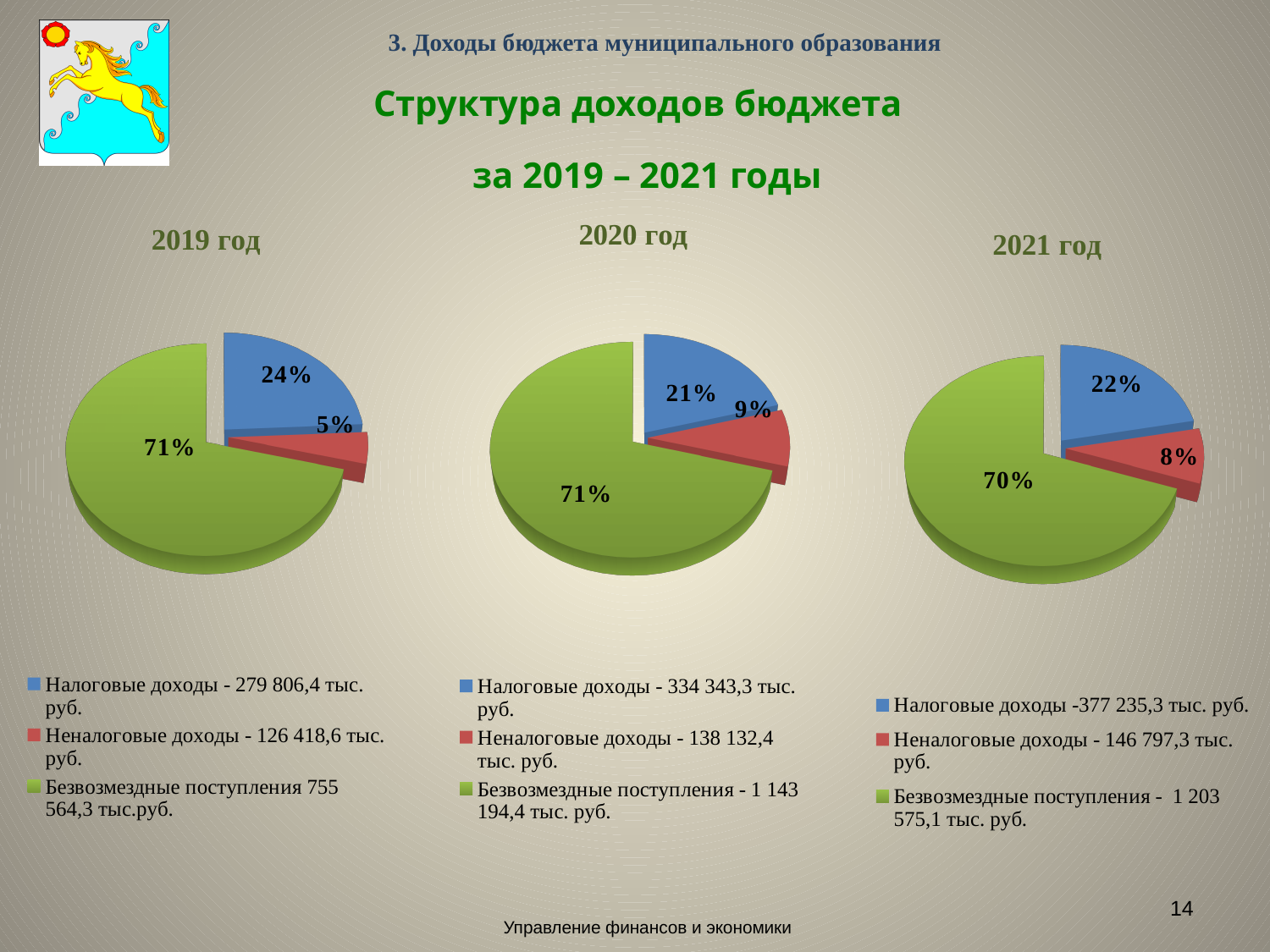
На диаграмме «2019 год» какую долю составляют Налоговые доходы? 24% Сколько секторов на диаграмме «2020 год»? 3 Какого типа диаграмма «2020 год»? Круговая диаграмма На диаграмме «2021 год» какая категория имеет наименьшую долю? Неналоговые доходы Согласно легенде диаграммы «2021 год», какова сумма Налоговых доходов? 377 235,3 тыс. руб. Каким цветом на диаграммах обозначены Безвозмездные поступления? Зелёным Сколько категорий перечислено в легенде диаграммы «2021 год»? 3 На диаграмме «2020 год» на сколько процентных пунктов доля Безвозмездных поступлений больше доли Налоговых доходов? 50 процентных пунктов На диаграмме «2020 год» какую долю составляют Неналоговые доходы? 9% На диаграмме «2019 год» какая категория имеет наибольшую долю? Безвозмездные поступления На диаграмме «2021 год» какую долю составляют Безвозмездные поступления? 70% На диаграмме «2019 год» что больше: доля Налоговых доходов или доля Неналоговых доходов? Налоговые доходы